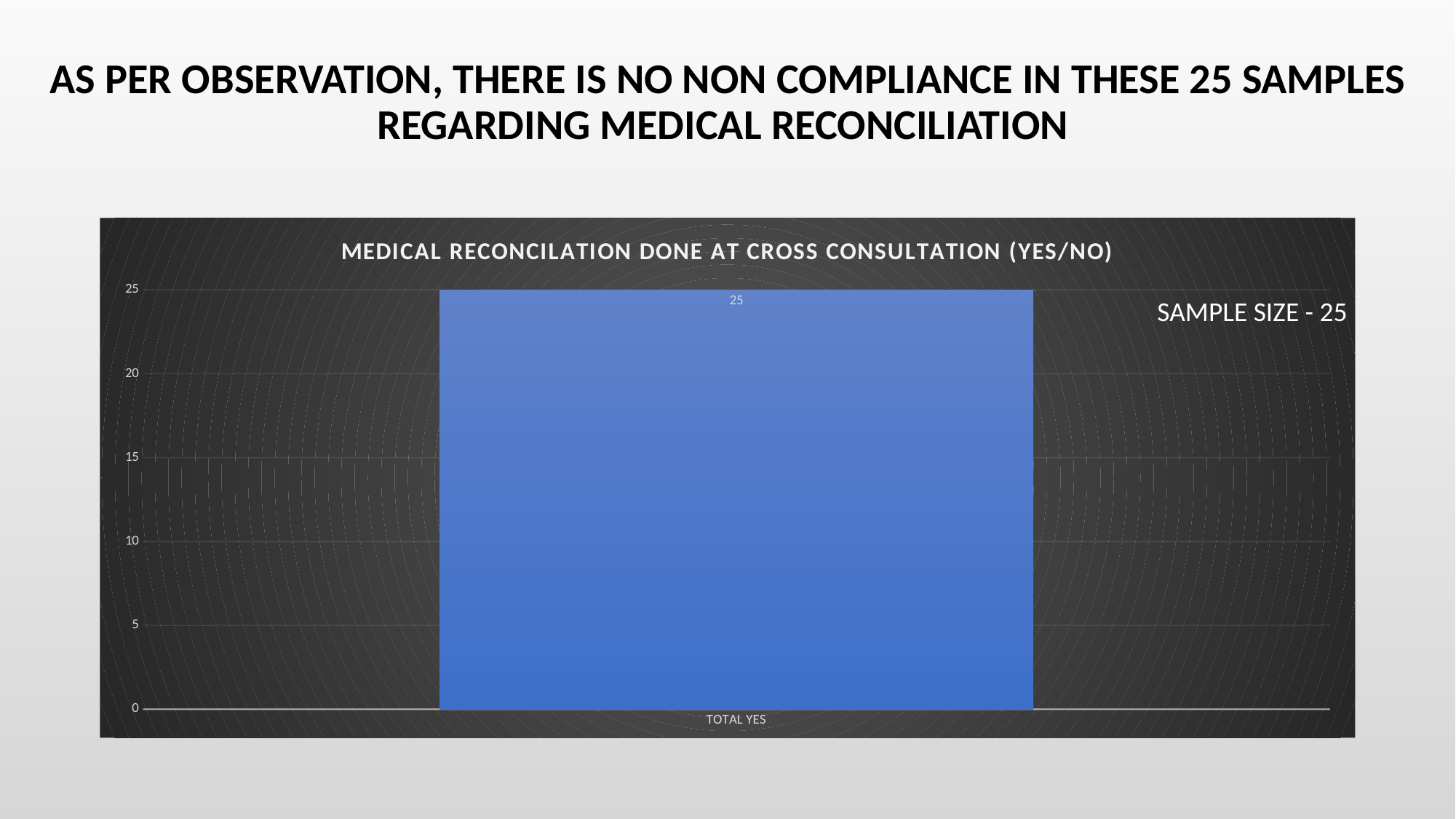
What is the label of the only category on the x axis? TOTAL YES Is the value for TOTAL YES greater or less than 10? greater How many categories are plotted on the x axis? 1 What is the value for TOTAL YES? 25 What kind of chart is shown on the slide? bar chart What is the title of the chart? MEDICAL RECONCILATION DONE AT CROSS CONSULTATION (YES/NO) Is the value for TOTAL YES greater or less than 20? greater What is the maximum value shown on the y axis? 25